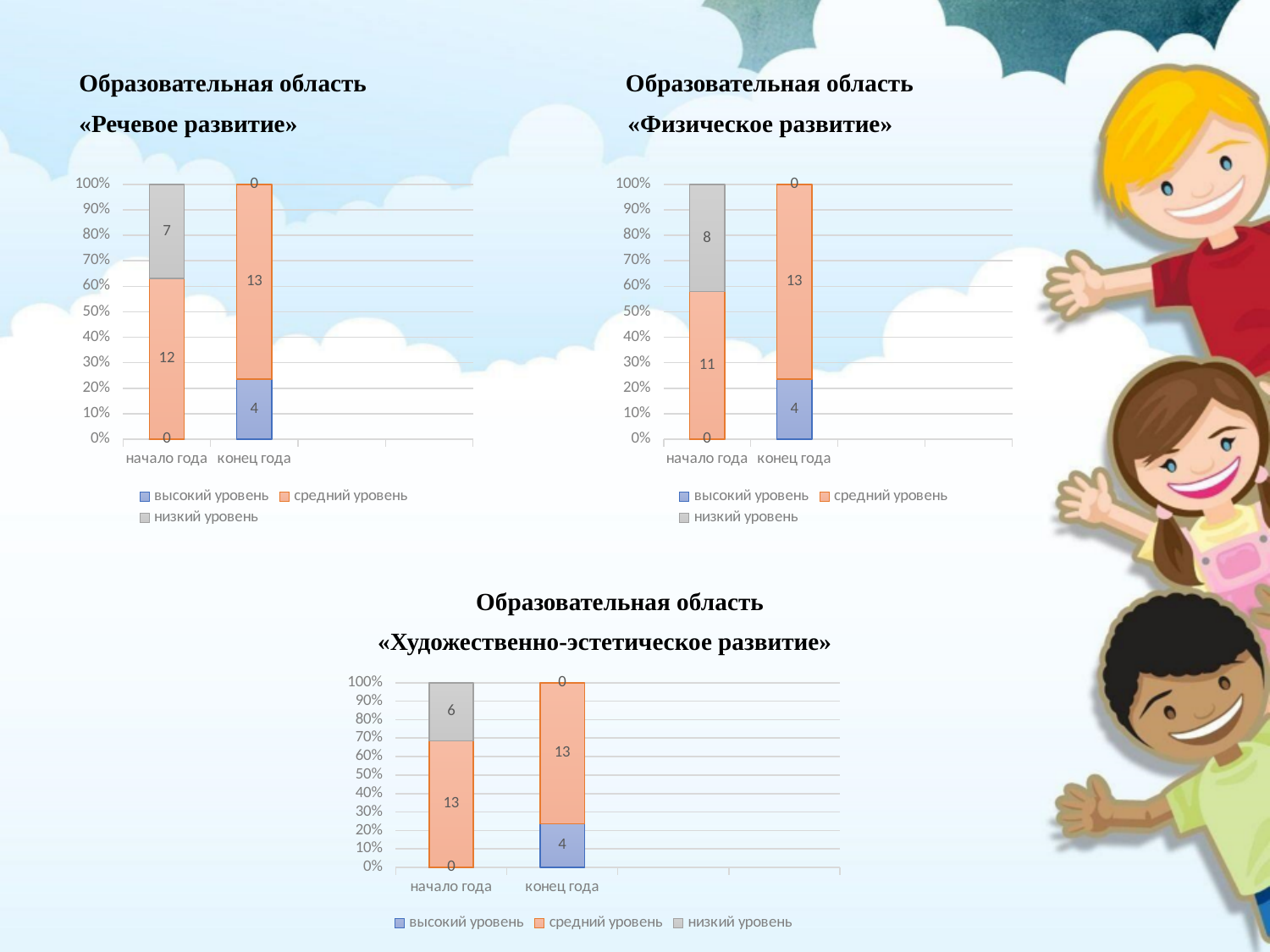
In the chart «Физическое развитие», what is the value of высокий уровень for конец года? 4 In the chart «Речевое развитие», what is the value of низкий уровень for начало года? 7 In the chart «Физическое развитие», which is larger: низкий уровень for начало года or высокий уровень for конец года? низкий уровень for начало года What type of chart is used for «Художественно-эстетическое развитие»? stacked bar chart In the chart «Речевое развитие», what is the value of средний уровень for начало года? 12 In the chart «Физическое развитие», what is the value of средний уровень for начало года? 11 In the chart «Художественно-эстетическое развитие», what is the value of средний уровень for конец года? 13 In the chart «Физическое развитие», what is the total of the data labels in the начало года bar? 19 In the chart «Речевое развитие», what is the difference between средний уровень for конец года and средний уровень for начало года? 1 In the chart «Художественно-эстетическое развитие», what is the total of the data labels in the конец года bar? 17 In the chart «Художественно-эстетическое развитие», what is the value of низкий уровень for начало года? 6 How many series does the legend of the chart «Речевое развитие» list? 3